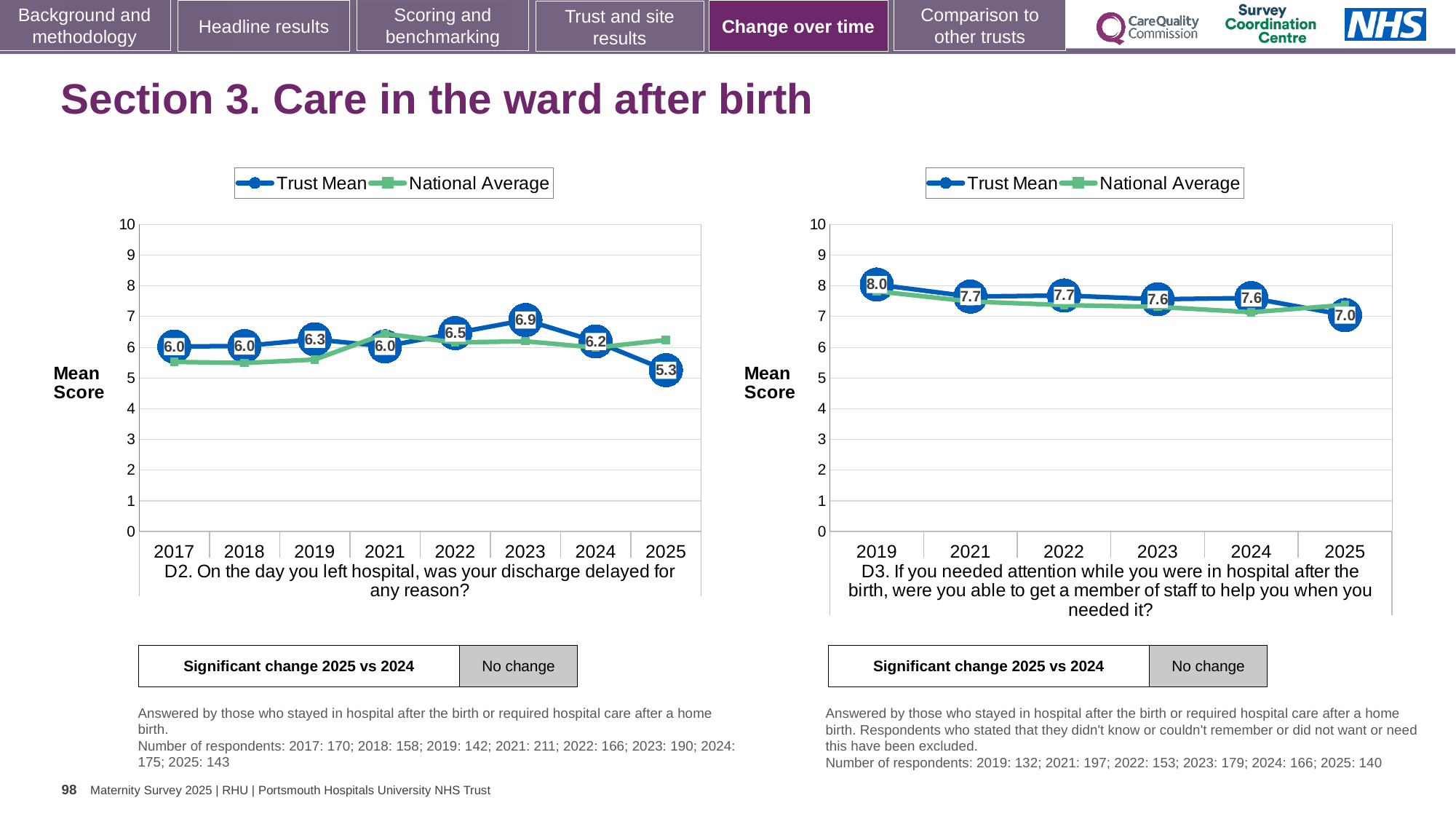
In the D2 chart (left), how many years are plotted on the x axis? 8 In the D2 chart (left), which year has the lowest Trust Mean? 2025 In the D3 chart (right), is the Trust Mean for 2019 greater or less than the Trust Mean for 2025? greater In the D2 chart (left), which year has the highest Trust Mean? 2023 In the D3 chart (right), what is the Trust Mean for 2025? 7.0 In the D3 chart (right), what is the Trust Mean for 2019? 8.0 In the D2 chart (left), what is the difference between the Trust Mean in 2023 and in 2025? 1.6 In the D2 chart (left), what is the Trust Mean for 2023? 6.9 What kind of chart is the D2 chart on the left? line chart In the D3 chart (right), does the Trust Mean rise or fall from 2019 to 2025? fall In the D3 chart (right), how many series does the legend list? 2 In the D2 chart (left), what is the Trust Mean for 2025? 5.3